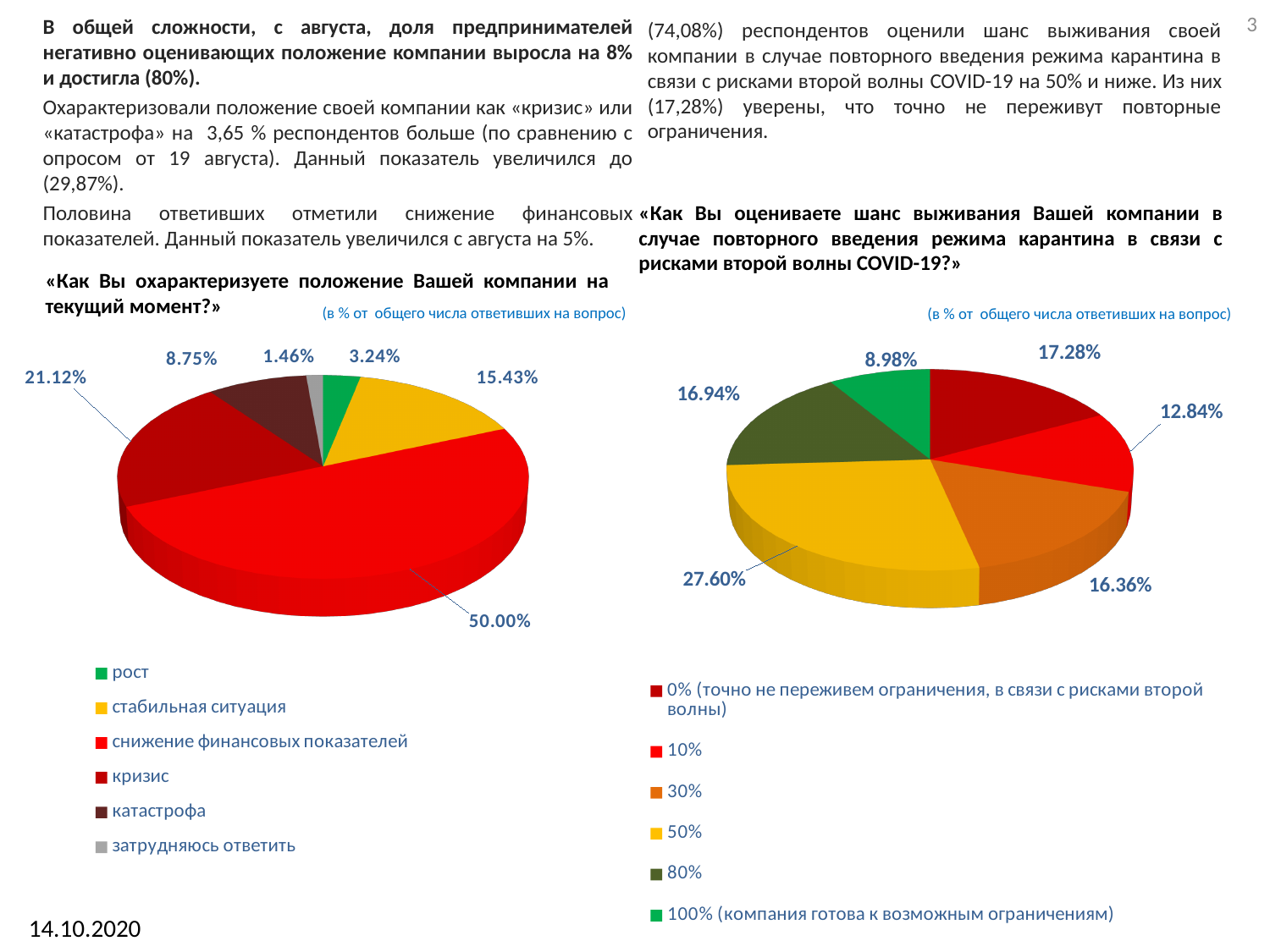
On the right chart («Как Вы оцениваете шанс выживания Вашей компании...»), which category has the smallest share? 100% (компания готова к возможным ограничениям) On the left chart («Как Вы охарактеризуете положение Вашей компании на текущий момент?»), what is the difference between the shares for «стабильная ситуация» and «рост»? 12.19% On the left chart («Как Вы охарактеризуете положение Вашей компании на текущий момент?»), what share of respondents chose «кризис»? 21.12% What type of chart is used on the right side of the slide («Как Вы оцениваете шанс выживания Вашей компании...»)? pie chart On the right chart («Как Вы оцениваете шанс выживания Вашей компании...»), what share of respondents chose 50%? 27.60% On the left chart («Как Вы охарактеризуете положение Вашей компании на текущий момент?»), how many categories does the legend list? 6 On the left chart («Как Вы охарактеризуете положение Вашей компании на текущий момент?»), what share of respondents chose «снижение финансовых показателей»? 50.00% On the right chart («Как Вы оцениваете шанс выживания Вашей компании...»), what share of respondents chose 0% (точно не переживем ограничения)? 17.28% On the right chart («Как Вы оцениваете шанс выживания Вашей компании...»), what is the difference between the shares for 80% and 30%? 0.58% On the left chart («Как Вы охарактеризуете положение Вашей компании на текущий момент?»), which is larger: «катастрофа» or «рост»? катастрофа On the right chart («Как Вы оцениваете шанс выживания Вашей компании...»), which category has the largest share? 50% On the left chart («Как Вы охарактеризуете положение Вашей компании на текущий момент?»), which category has the smallest share? затрудняюсь ответить